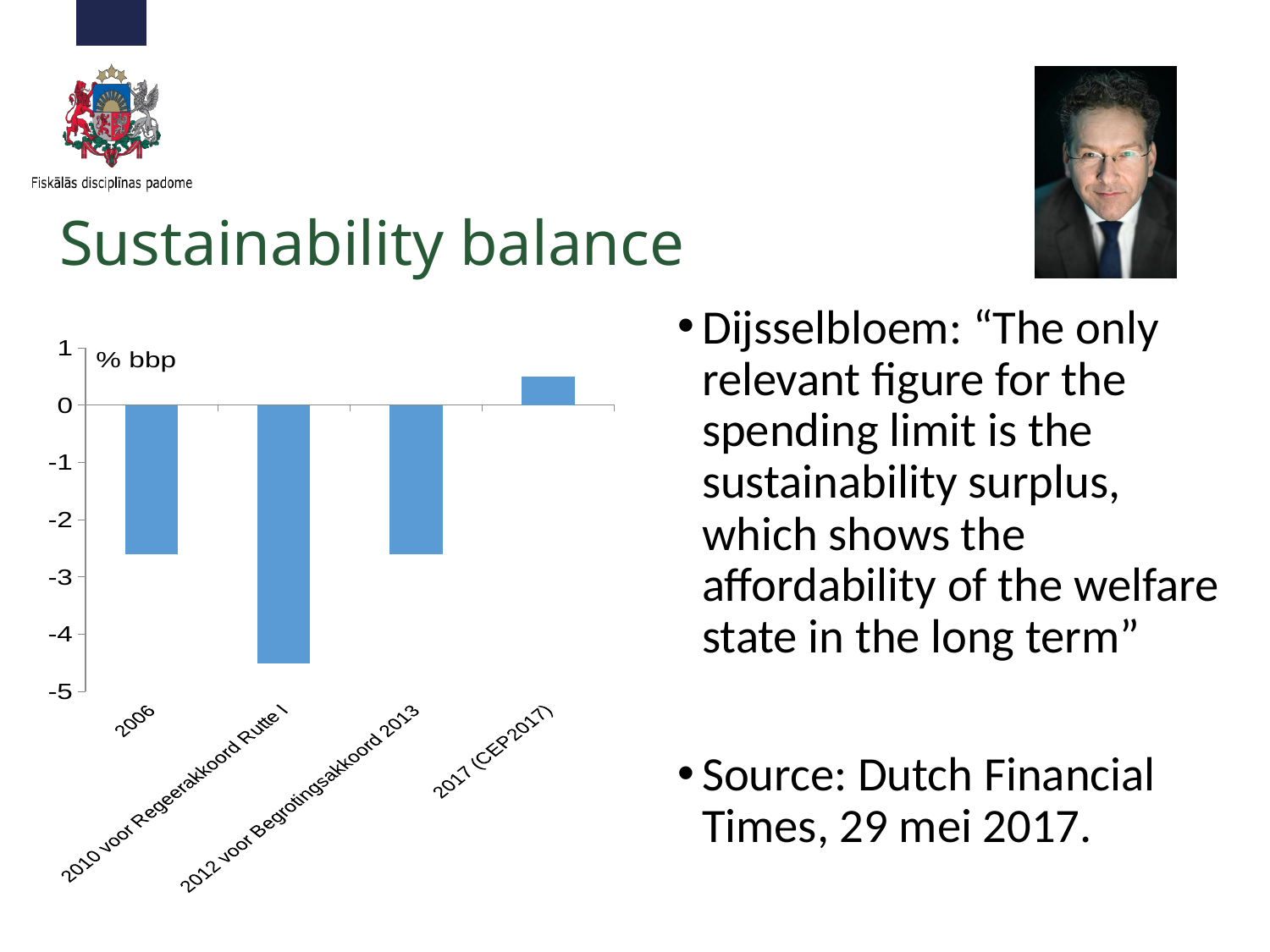
Is the value for 2012 voor Begrotingsakkoord 2013 greater or less than -3? greater Is the value for 2017 (CEP2017) greater or less than 0? greater Which category is the only one with a positive value in the chart? 2017 (CEP2017) Which category has the highest value in the chart? 2017 (CEP2017) Which category has the lowest value in the chart? 2010 voor Regeerakkoord Rutte I Which is larger, the value for 2017 (CEP2017) or the value for 2010 voor Regeerakkoord Rutte I? 2017 (CEP2017) Is the value for 2010 voor Regeerakkoord Rutte I greater or less than -4? less What unit label is shown at the top of the chart's y axis? % bbp How many categories are shown on the x axis of the chart? 4 What kind of chart is shown on the slide? bar chart Which is larger, the value for 2006 or the value for 2010 voor Regeerakkoord Rutte I? 2006